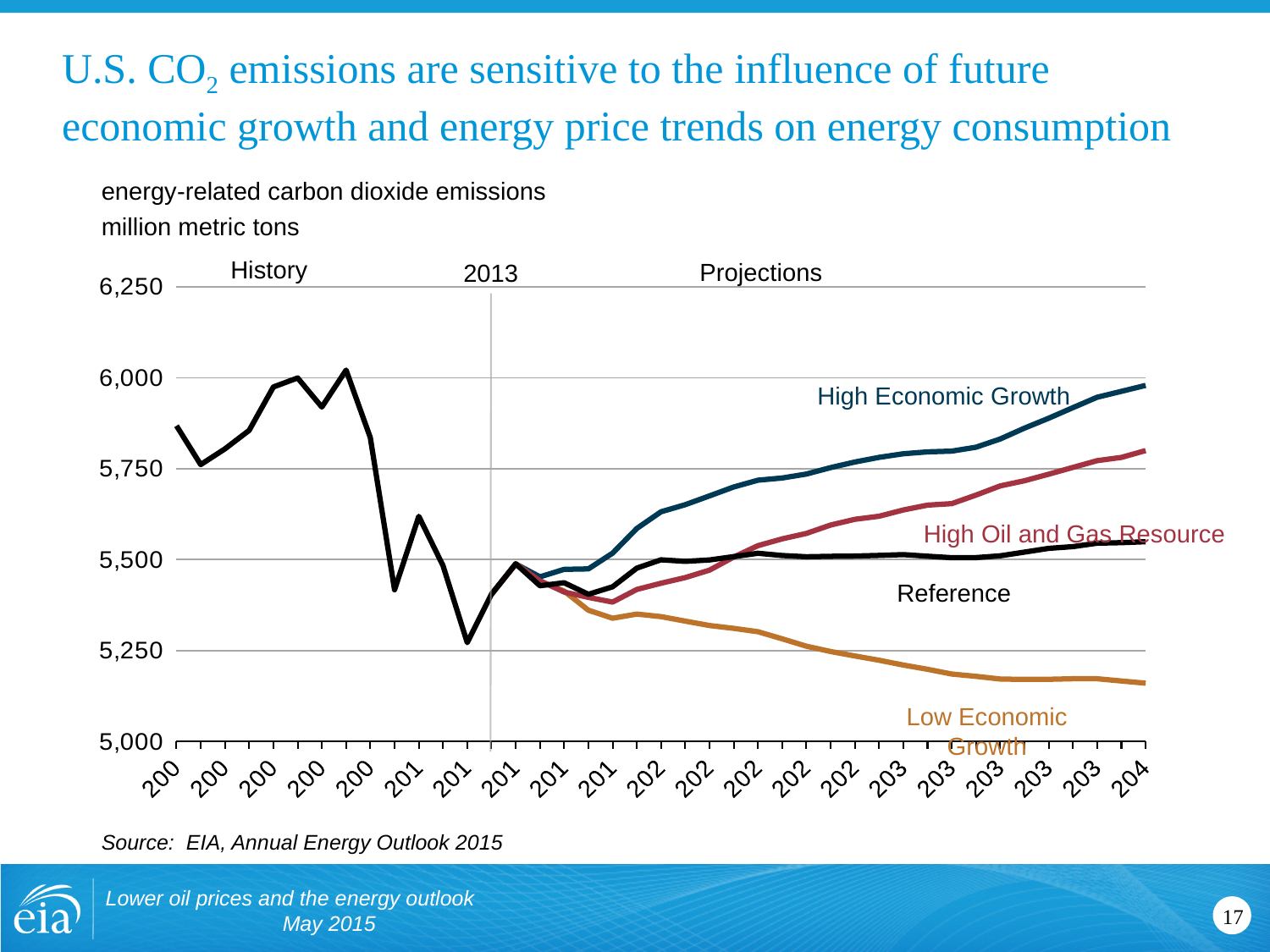
At the end of the projection period, which is higher: High Economic Growth or Reference? High Economic Growth Does the High Economic Growth series rise or fall over the projection period? rise How many labelled projection series are shown on the chart? 4 What unit is used on the y axis of the chart? million metric tons Does the Low Economic Growth series rise or fall over the projection period? fall Which projection series has the lowest emissions at the end of the projection period? Low Economic Growth What kind of chart is shown on the slide? line chart At the end of the projection period, which is higher: High Oil and Gas Resource or Reference? High Oil and Gas Resource Is the High Economic Growth value at the end of the projection period greater or less than 5,750? greater Which projection series has the highest emissions at the end of the projection period? High Economic Growth Is the Low Economic Growth value at the end of the projection period greater or less than 5,250? less Which year does the vertical line separating History from Projections mark? 2013